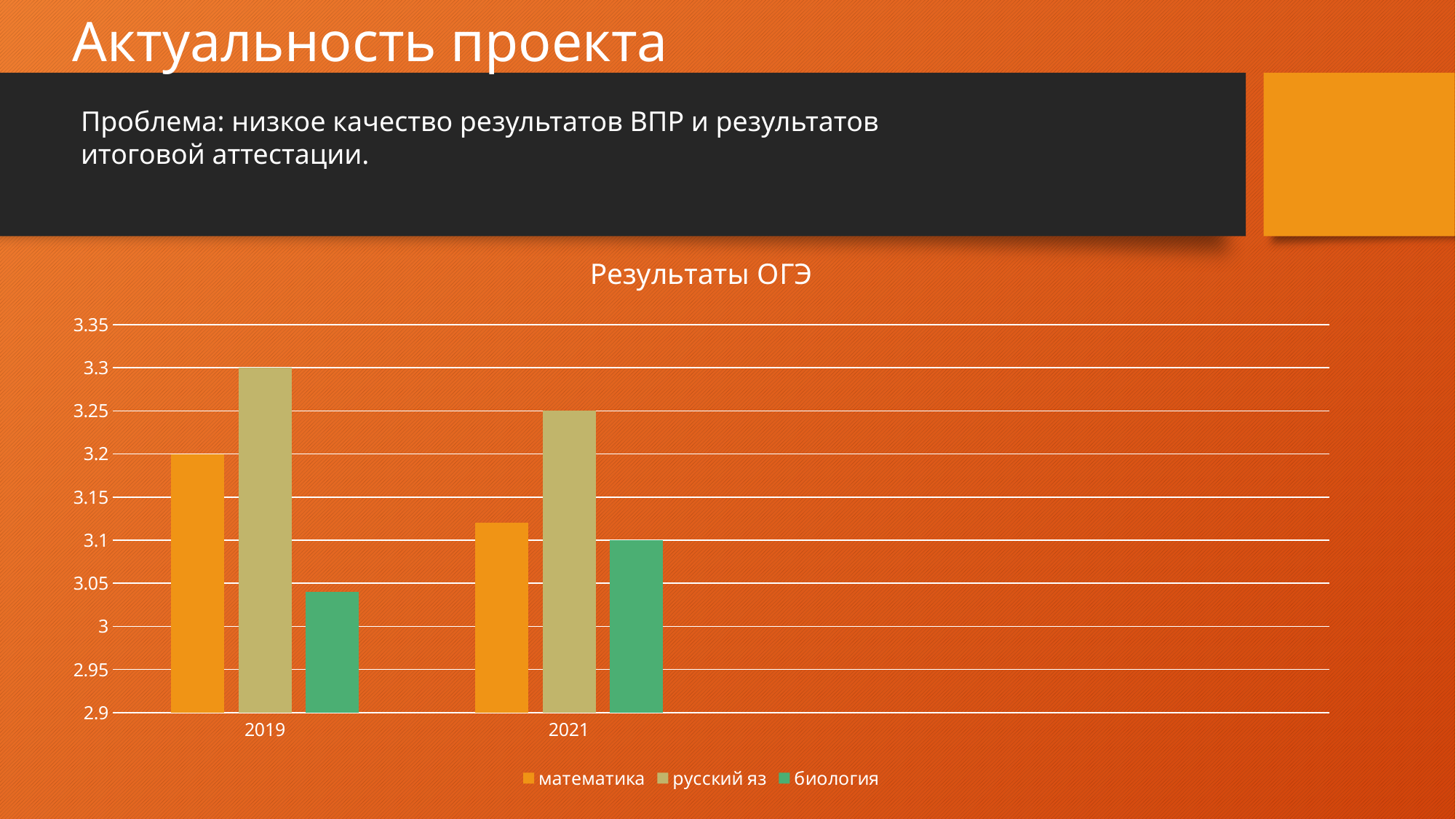
What is the value for математика in 2019? 3.2 Is the value for биология in 2019 greater or less than 3.05? less Which series has the highest value in 2019? русский яз What is the value for русский яз in 2019? 3.3 What is the value for русский яз in 2021? 3.25 Which series has the lowest value in 2021? биология What kind of chart is shown under the title "Результаты ОГЭ"? bar chart What is the value for биология in 2021? 3.1 How many series does the legend of the "Результаты ОГЭ" chart list? 3 Which is larger: the value for математика in 2019 or in 2021? 2019 Is the value for математика in 2021 greater or less than 3.1? greater How many year categories are shown on the x axis of the "Результаты ОГЭ" chart? 2